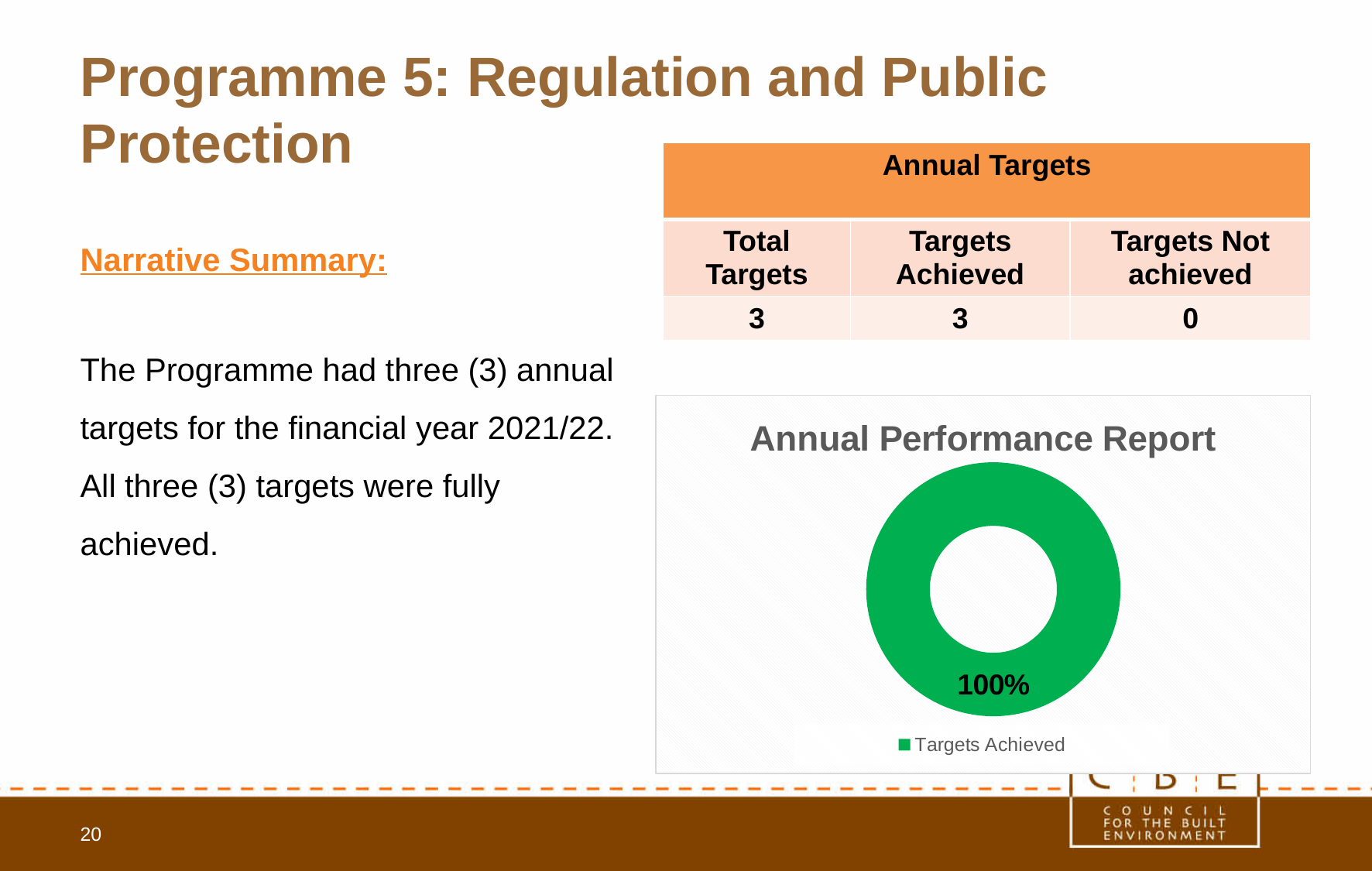
How many entries does the legend of the Annual Performance Report chart list? 1 What is the title of the chart on the slide? Annual Performance Report What kind of chart is the Annual Performance Report? doughnut chart What is the legend entry shown on the Annual Performance Report chart? Targets Achieved How many slices are shown in the Annual Performance Report chart? 1 What share of the Annual Performance Report doughnut does the Targets Achieved slice take up? 100% What percentage is shown on the Annual Performance Report chart for Targets Achieved? 100%